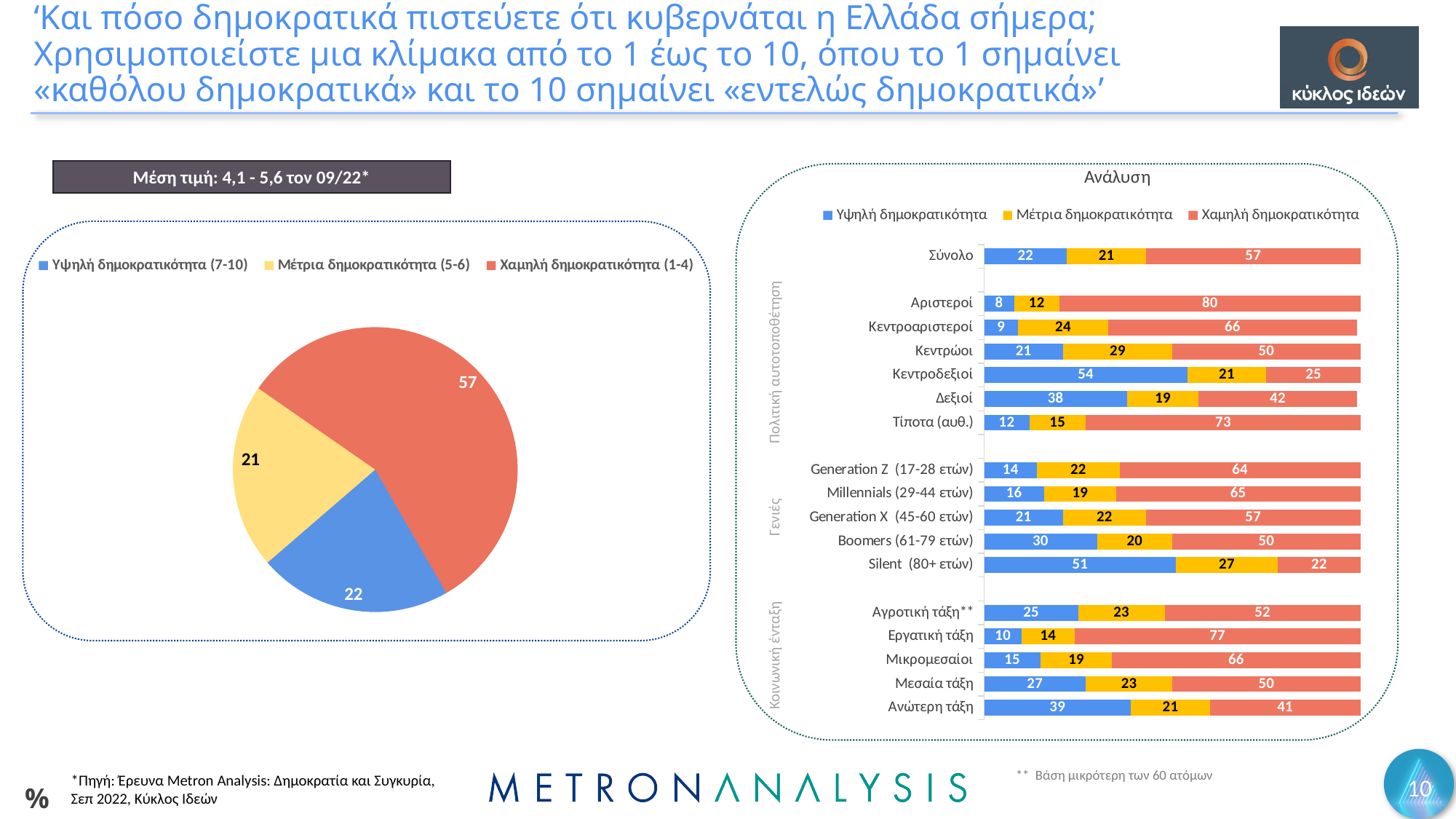
In the chart titled Ανάλυση, which is larger: the Υψηλή δημοκρατικότητα value for Silent (80+ ετών) or for Boomers (61-79 ετών)? Silent (80+ ετών) In the pie chart on the left, how many slices are there? 3 What kind of chart is the chart titled Ανάλυση on the right? Stacked bar chart In the chart titled Ανάλυση, what is the Χαμηλή δημοκρατικότητα value for Αριστεροί? 80 How many series does the legend of the chart titled Ανάλυση list? 3 In the pie chart on the left, what is the value of the Χαμηλή δημοκρατικότητα (1-4) slice? 57 In the chart titled Ανάλυση, which category has the lowest Υψηλή δημοκρατικότητα value? Αριστεροί In the pie chart on the left, what is the difference between the Χαμηλή δημοκρατικότητα (1-4) slice and the Υψηλή δημοκρατικότητα (7-10) slice? 35 In the chart titled Ανάλυση, what is the Υψηλή δημοκρατικότητα value for Κεντροδεξιοί? 54 In the chart titled Ανάλυση, which category has the highest Χαμηλή δημοκρατικότητα value? Αριστεροί In the pie chart on the left, which slice is the largest? Χαμηλή δημοκρατικότητα (1-4) In the chart titled Ανάλυση, what is the difference between the Χαμηλή δημοκρατικότητα values for Εργατική τάξη and Ανώτερη τάξη? 36